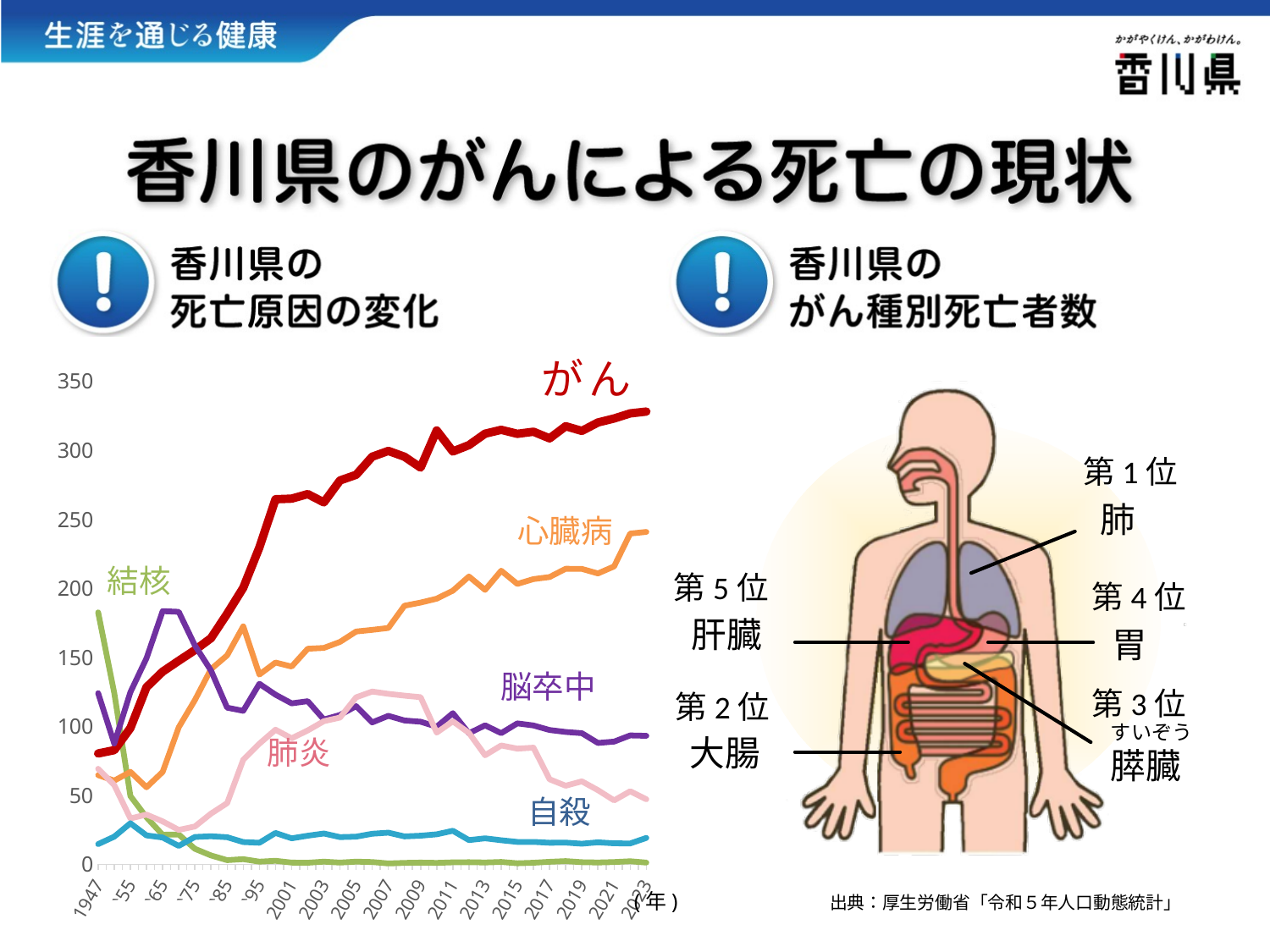
In the 香川県の死亡原因の変化 chart, does the 結核 line rise or fall from 1947 to 2023? fall In the 香川県の死亡原因の変化 chart, does the がん line generally rise or fall from 1947 to 2023? rise How many causes of death (series) are labeled on the 香川県の死亡原因の変化 line chart? 6 What kind of chart is the 香川県の死亡原因の変化 chart? line chart In the 香川県の死亡原因の変化 chart, which cause of death has the lowest value in 2023? 結核 In the 香川県の死亡原因の変化 chart, is the value for 脳卒中 in 2023 greater or less than 150? less In the 香川県の死亡原因の変化 chart, which cause of death has the highest value in 2023? がん In the 香川県の死亡原因の変化 chart, is the value for 心臓病 in 2023 greater or less than 200? greater What is the highest tick value shown on the vertical axis of the 香川県の死亡原因の変化 chart? 350 In the 香川県の死亡原因の変化 chart, is the value for がん in 2023 greater or less than 300? greater In the 香川県の死亡原因の変化 chart, which is larger in 2023, 心臓病 or 脳卒中? 心臓病